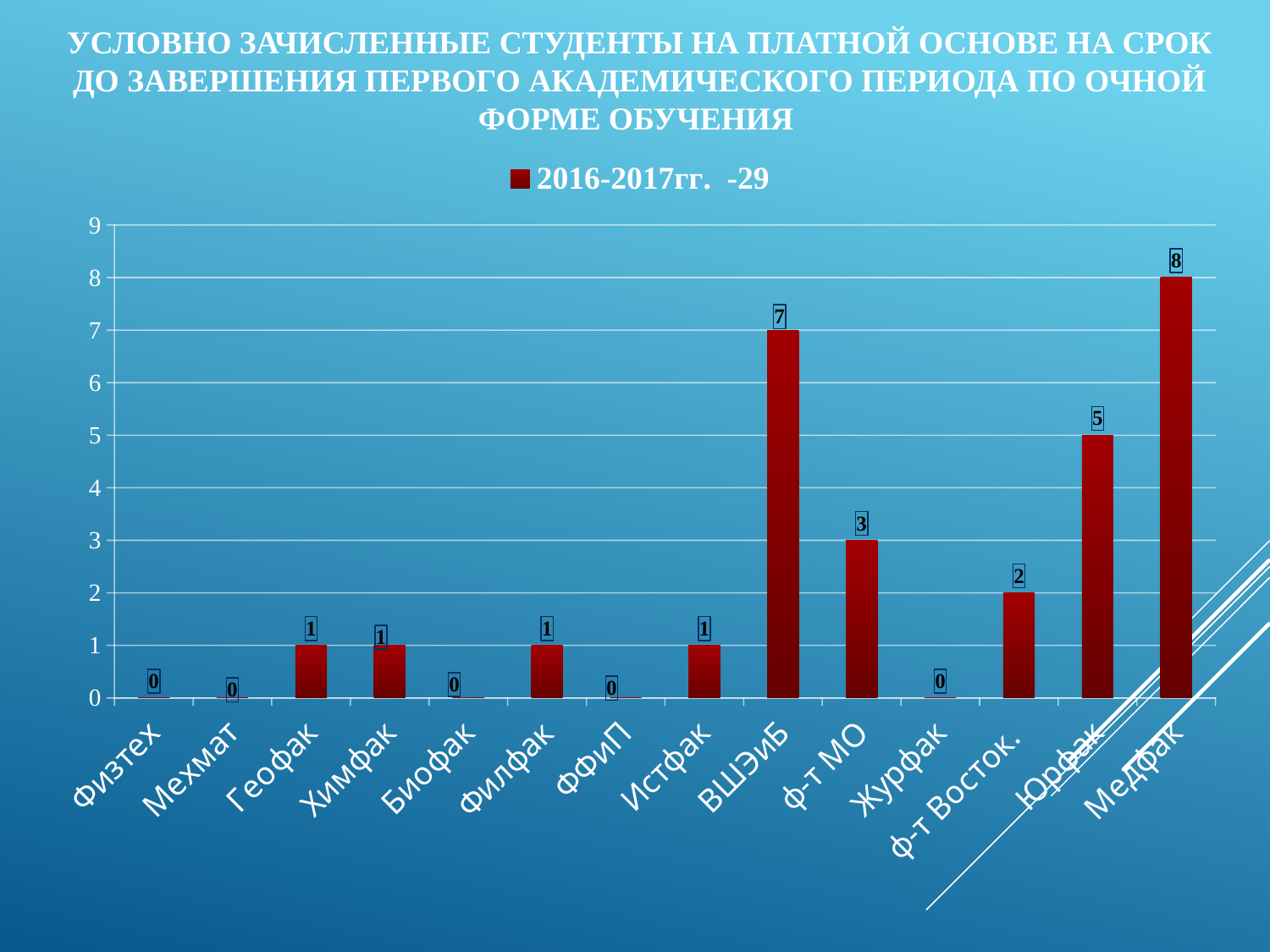
Which category has the highest value? Медфак What is the legend entry for the series? 2016-2017гг. -29 Which is larger, the value for ф-т МО or the value for Юрфак? Юрфак What is the value for Медфак? 8 What is the difference between the values for Медфак and ВШЭиБ? 1 How many series does the legend list? 1 What kind of chart is shown on the slide? bar chart What is the value for ВШЭиБ? 7 What is the difference between the values for Юрфак and ф-т Восток.? 3 What is the value for ф-т МО? 3 What is the value for Юрфак? 5 How many categories are shown on the x axis? 14